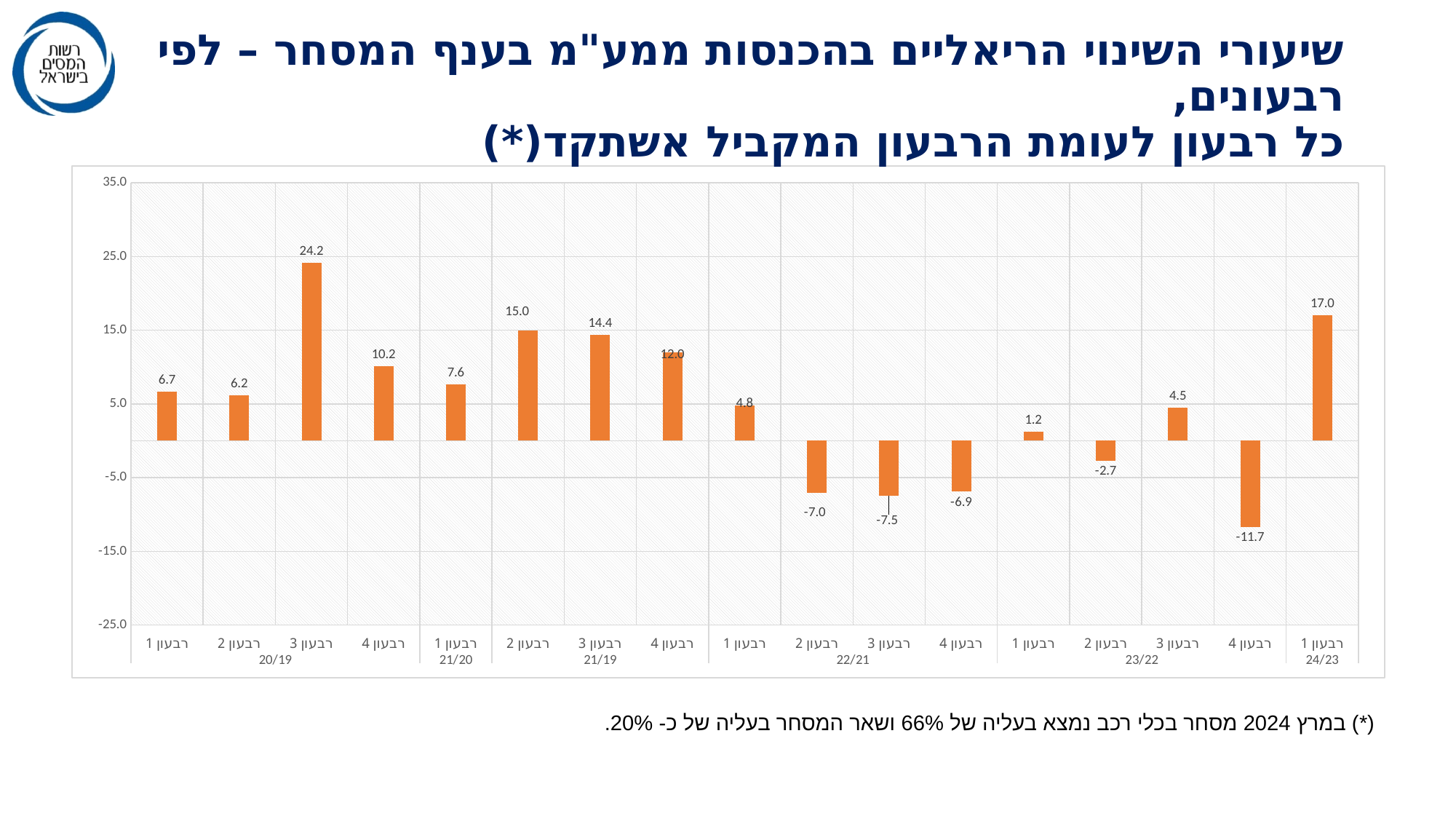
What kind of chart is shown on the slide? bar chart Is the value for רבעון 1 of 24/23 greater or less than 15.0? greater What is the difference between the values for רבעון 2 of 21/19 and רבעון 3 of 21/19? 0.6 How many quarters in the chart have negative values? 5 How many bars are plotted in the chart? 17 What is the value for רבעון 3 of 20/19? 24.2 Which quarter has the highest value in the chart? רבעון 3 of 20/19 What is the value for רבעון 1 of 24/23? 17.0 What is the value for רבעון 4 of 23/22? -11.7 Which is larger, the value for רבעון 4 of 20/19 or the value for רבעון 1 of 21/20? רבעון 4 of 20/19 Which quarter has the lowest value in the chart? רבעון 4 of 23/22 What colour are the bars in the chart? orange